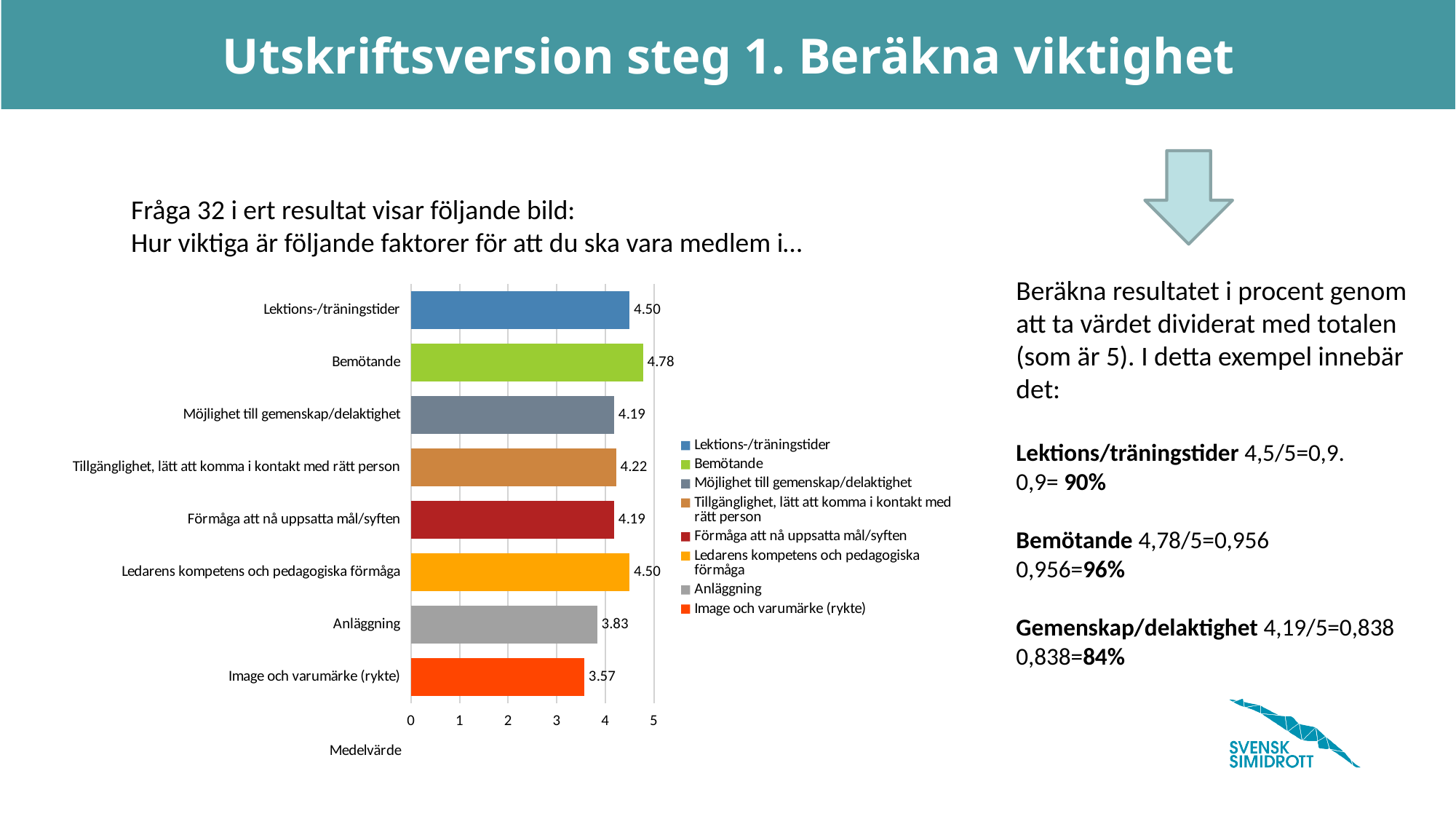
How many categories are shown in the chart? 8 What is the difference between the values for Lektions-/träningstider and Anläggning? 0.67 What is the value for Bemötande? 4.78 What is the difference between the values for Bemötande and Image och varumärke (rykte)? 1.21 Which is larger, the value for Anläggning or the value for Image och varumärke (rykte)? Anläggning Which category has the lowest value? Image och varumärke (rykte) What kind of chart is shown on the slide? bar chart What is the value for Anläggning? 3.83 Is the value for Anläggning greater or less than 4? less Which category has the highest value? Bemötande What is the value for Tillgänglighet, lätt att komma i kontakt med rätt person? 4.22 What is the label on the horizontal axis of the chart? Medelvärde